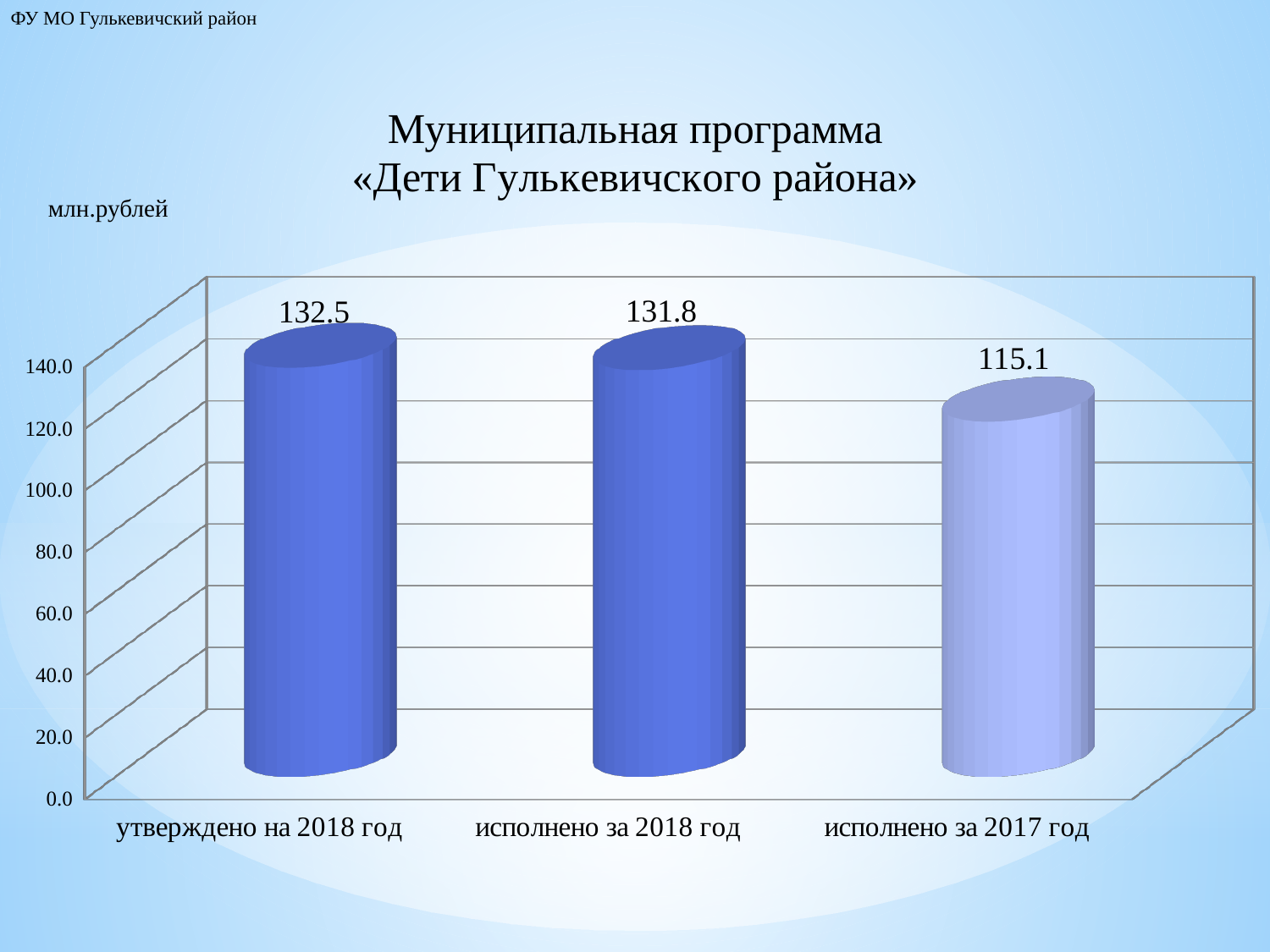
What kind of chart is shown on the slide? bar chart What is the difference between the values for «исполнено за 2018 год» and «исполнено за 2017 год»? 16.7 What unit is indicated for the values on the chart? млн.рублей How many categories are shown on the chart? 3 What is the difference between the values for «утверждено на 2018 год» and «исполнено за 2018 год»? 0.7 What is the value for «исполнено за 2017 год»? 115.1 What is the value for «утверждено на 2018 год»? 132.5 What is the value for «исполнено за 2018 год»? 131.8 Which is larger: the value for «исполнено за 2018 год» or «исполнено за 2017 год»? исполнено за 2018 год Which category has the lowest value? исполнено за 2017 год Is the value for «исполнено за 2017 год» greater or less than 120.0? less Which category has the highest value? утверждено на 2018 год